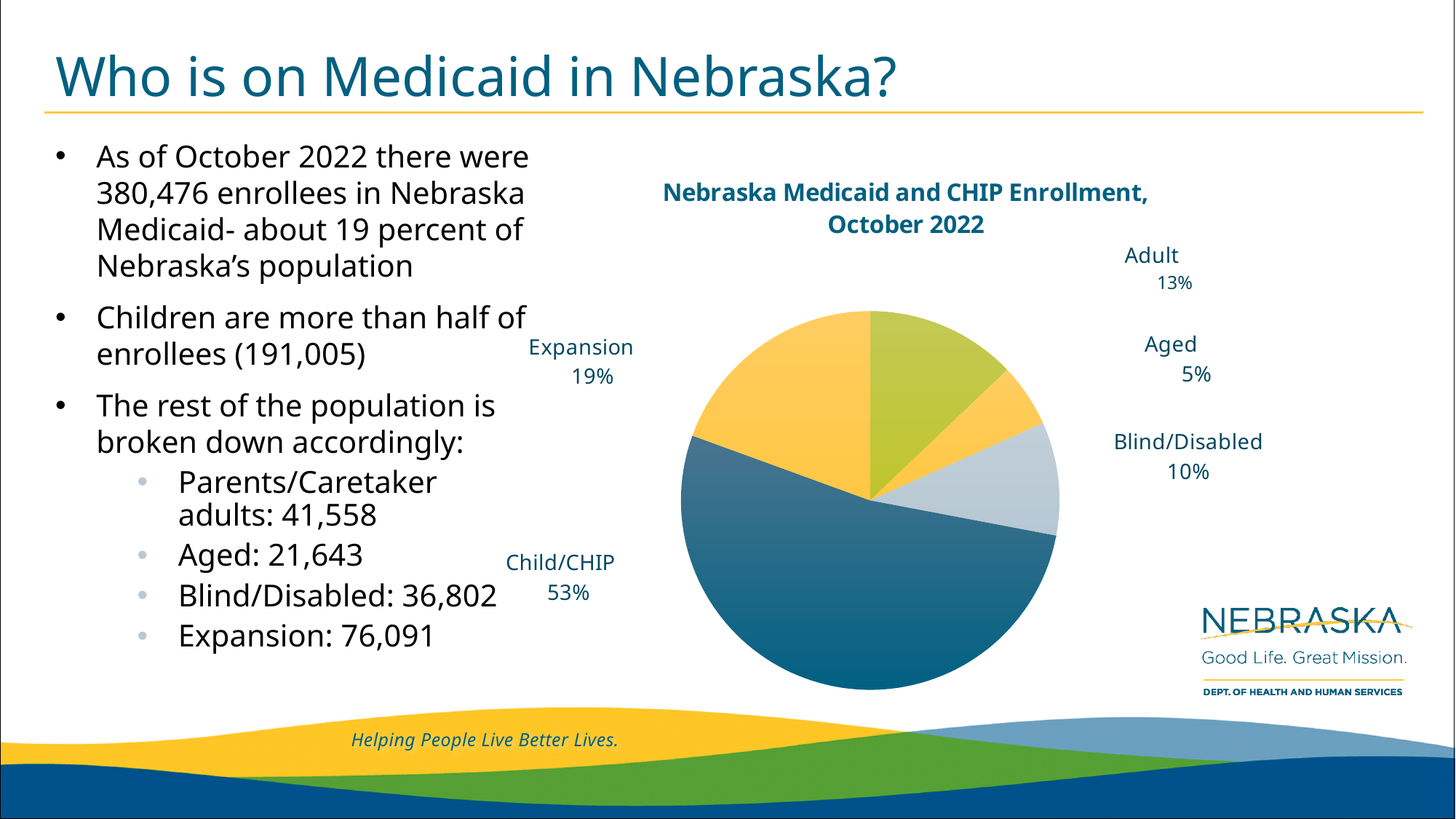
Which is larger, the Blind/Disabled share or the Aged share? Blind/Disabled How many categories are shown in the pie chart? 5 Which category has the largest share of the pie? Child/CHIP What is the difference in percentage points between the Expansion and Adult shares? 6 Which category has the smallest share of the pie? Aged What share of enrollment is Blind/Disabled? 10% What share of enrollment is Adult? 13% What share of enrollment is Child/CHIP? 53% What kind of chart is shown on the slide? pie chart What is the title of the chart? Nebraska Medicaid and CHIP Enrollment, October 2022